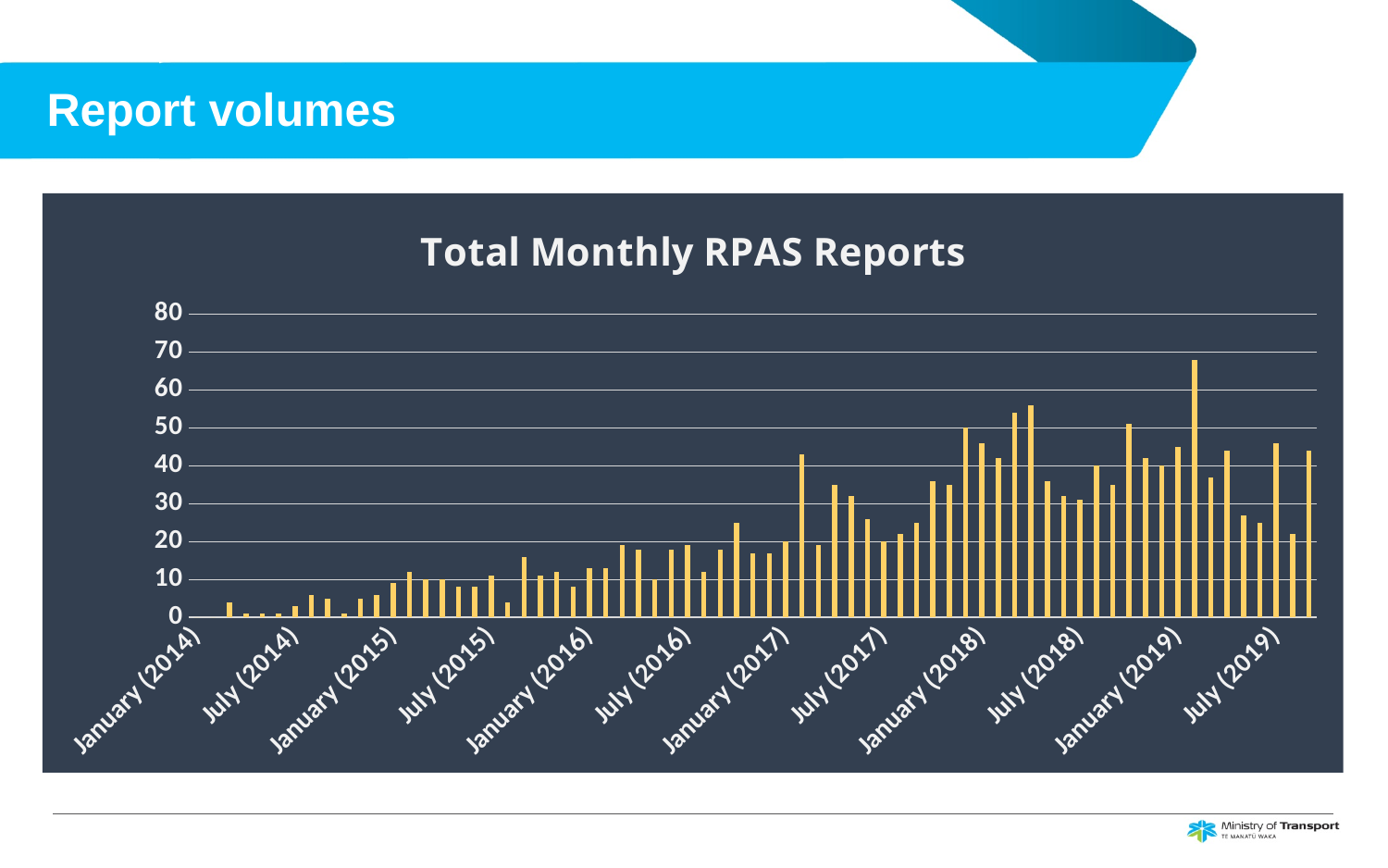
Which is larger, the value for January (2014) or the value for January (2019)? January (2019) Do the monthly report volumes generally rise or fall from January (2014) to 2019? rise Is the value for July (2016) greater or less than 40? less What kind of chart is shown on the slide? bar chart Is the value for January (2019) greater or less than 20? greater Is the value for January (2014) greater or less than 10? less What is the title of the chart? Total Monthly RPAS Reports